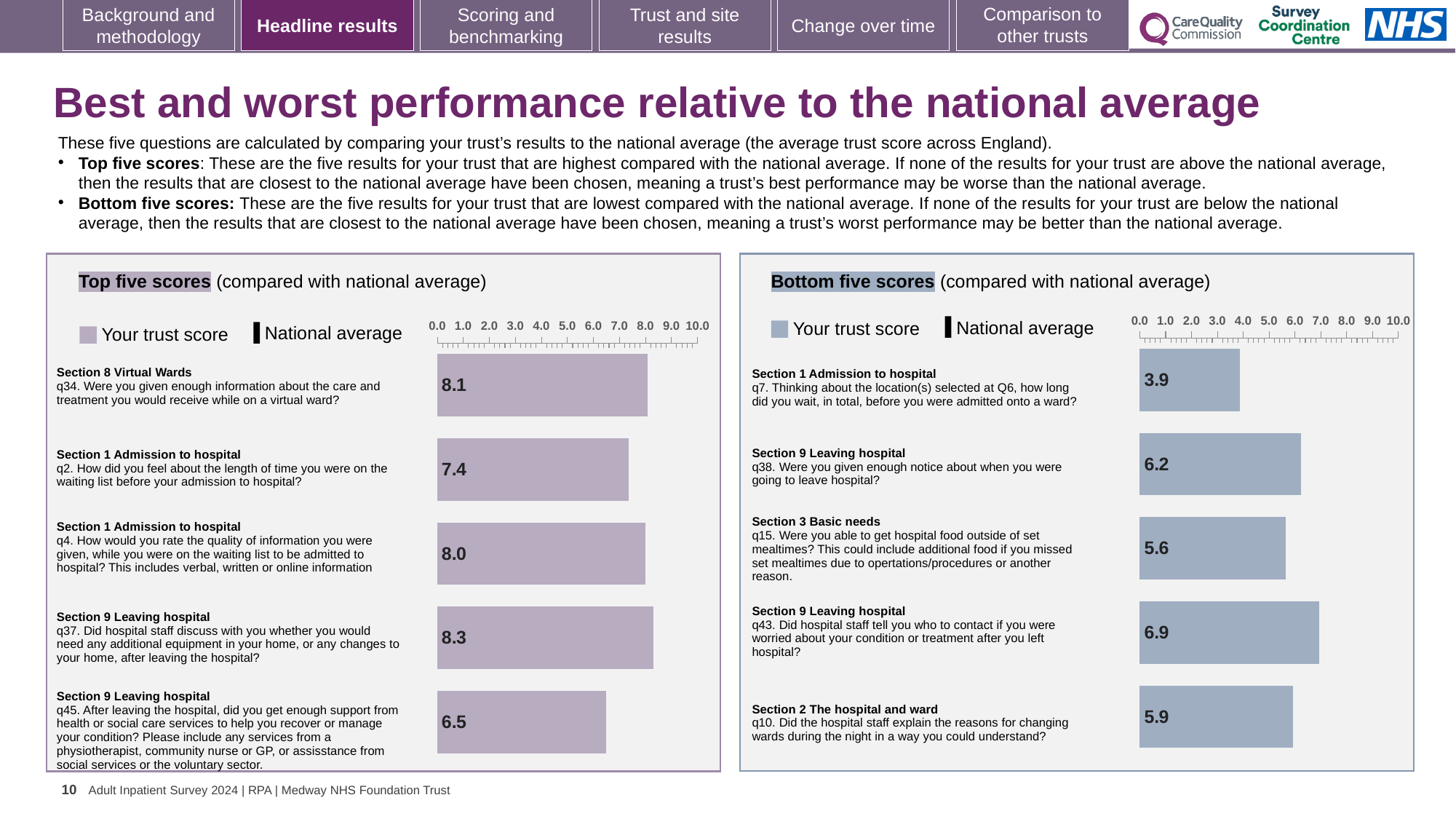
How many bars are plotted in the Top five scores chart? 5 In the Top five scores chart, what is the difference between the trust scores for q37 and q45? 1.8 In the Top five scores chart, which question has the highest trust score? q37 In the Bottom five scores chart, what is the trust score for q7 (Section 1 Admission to hospital)? 3.9 In the Bottom five scores chart, which question has the highest trust score? q43 In the Bottom five scores chart, which has the larger trust score, q38 or q10? q38 In the Bottom five scores chart, what is the difference between the trust scores for q43 and q7? 3.0 In the Bottom five scores chart, which question has the lowest trust score? q7 In the Top five scores chart, what is the trust score for q34 (Section 8 Virtual Wards)? 8.1 In the Top five scores chart, which question has the lowest trust score? q45 What type of chart is the Bottom five scores chart? Bar chart In the Top five scores chart, what is the trust score for q45 (Section 9 Leaving hospital)? 6.5